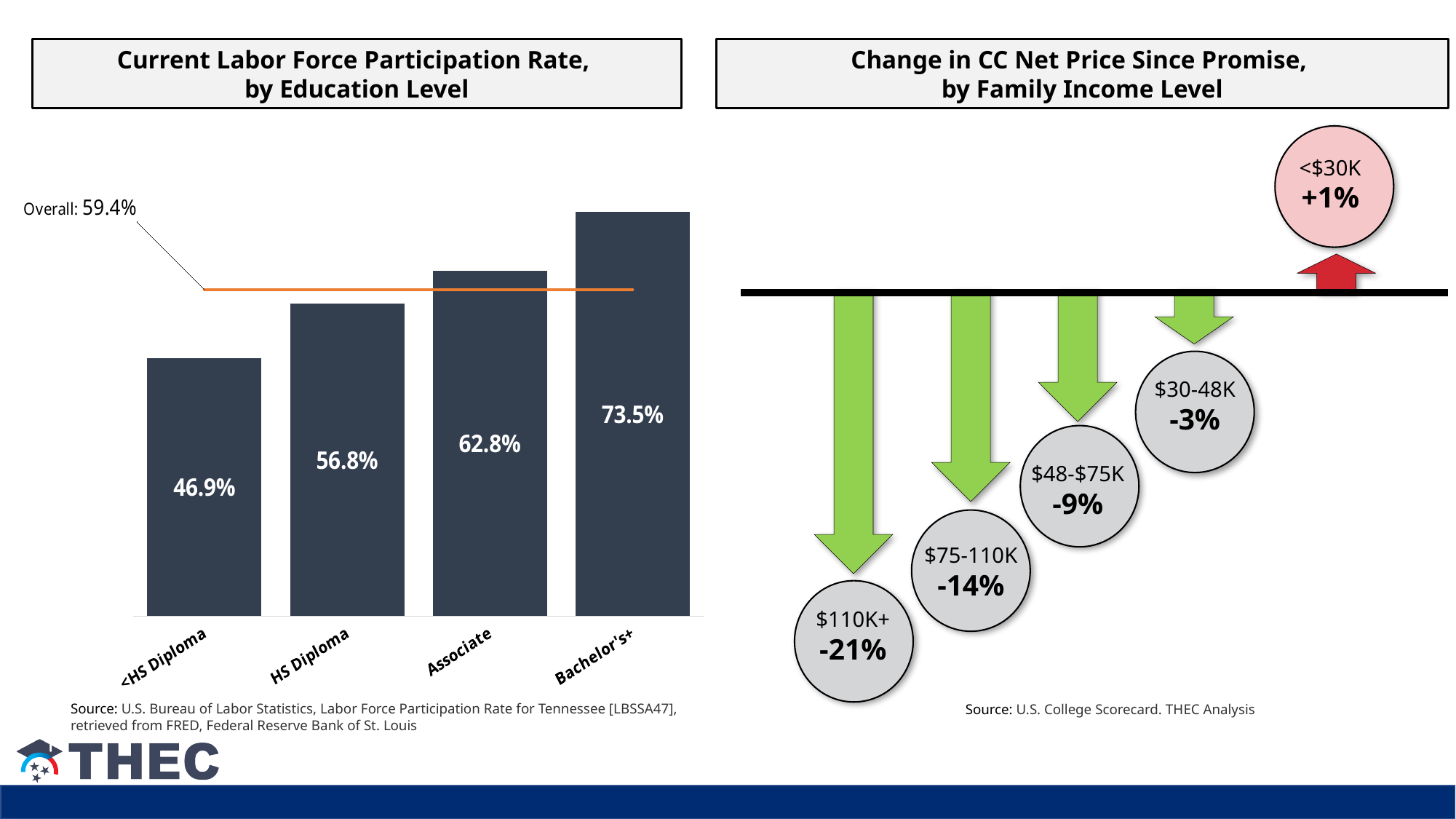
In the 'Current Labor Force Participation Rate, by Education Level' chart, what is the value for <HS Diploma? 46.9% In the 'Current Labor Force Participation Rate, by Education Level' chart, do the values rise or fall from <HS Diploma to Bachelor's+? Rise In the 'Current Labor Force Participation Rate, by Education Level' chart, what is the value for Associate? 62.8% In the 'Current Labor Force Participation Rate, by Education Level' chart, how many education levels are plotted? 4 In the 'Current Labor Force Participation Rate, by Education Level' chart, which education level has the lowest participation rate? <HS Diploma In the 'Change in CC Net Price Since Promise, by Family Income Level' chart, which is larger in magnitude, the change for $75-110K or for $48-$75K? $75-110K In the 'Current Labor Force Participation Rate, by Education Level' chart, what is the overall participation rate shown by the horizontal line? 59.4% In the 'Change in CC Net Price Since Promise, by Family Income Level' chart, what is the change for the $110K+ income level? -21% In the 'Change in CC Net Price Since Promise, by Family Income Level' chart, which family income level is the only one with an increase in net price? <$30K What kind of chart is 'Current Labor Force Participation Rate, by Education Level'? Bar chart In the 'Current Labor Force Participation Rate, by Education Level' chart, what is the difference between the Bachelor's+ and HS Diploma values? 16.7% In the 'Current Labor Force Participation Rate, by Education Level' chart, which education level has the highest participation rate? Bachelor's+